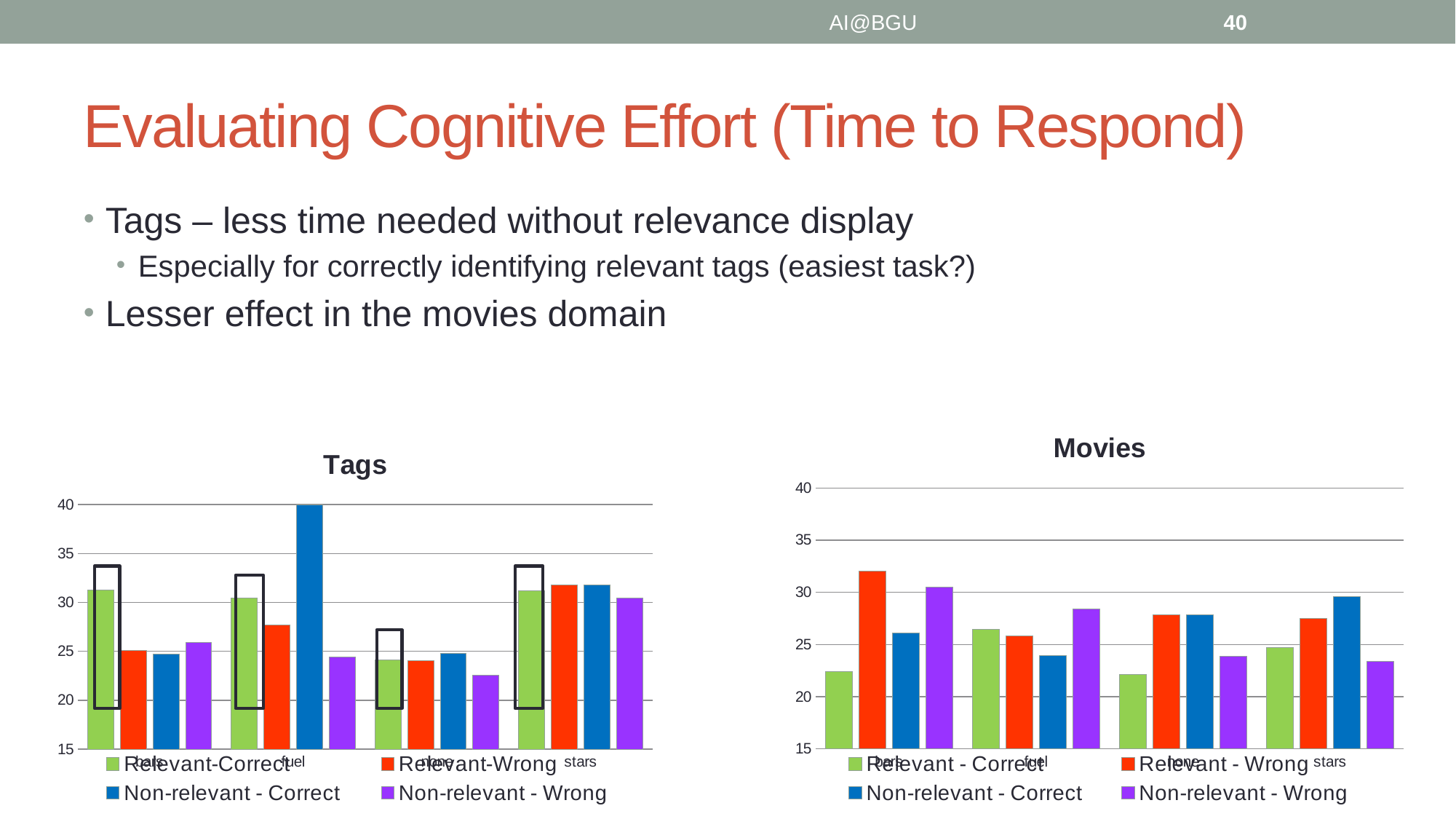
In the Tags chart, for the bars category, which is larger: Relevant-Correct or Relevant-Wrong? Relevant-Correct In the Movies chart, for the bars category, which is larger: Relevant - Wrong or Non-relevant - Correct? Relevant - Wrong In the Tags chart, is the Relevant-Correct value for none greater or less than 30? less In the Movies chart, which category has the highest Non-relevant - Correct value? stars What is the title of the chart on the right side of the slide? Movies In the Tags chart, is the Non-relevant - Correct value for fuel greater or less than 35? greater In the Movies chart, which category has the highest Relevant - Wrong value? bars How many categories are shown on the x axis of the Tags chart? 4 In the Tags chart, which category has the highest Non-relevant - Correct value? fuel What kind of chart is the Tags chart? bar chart In the Movies chart, is the Relevant - Wrong value for bars greater or less than 30? greater How many series does the legend of the Tags chart list? 4